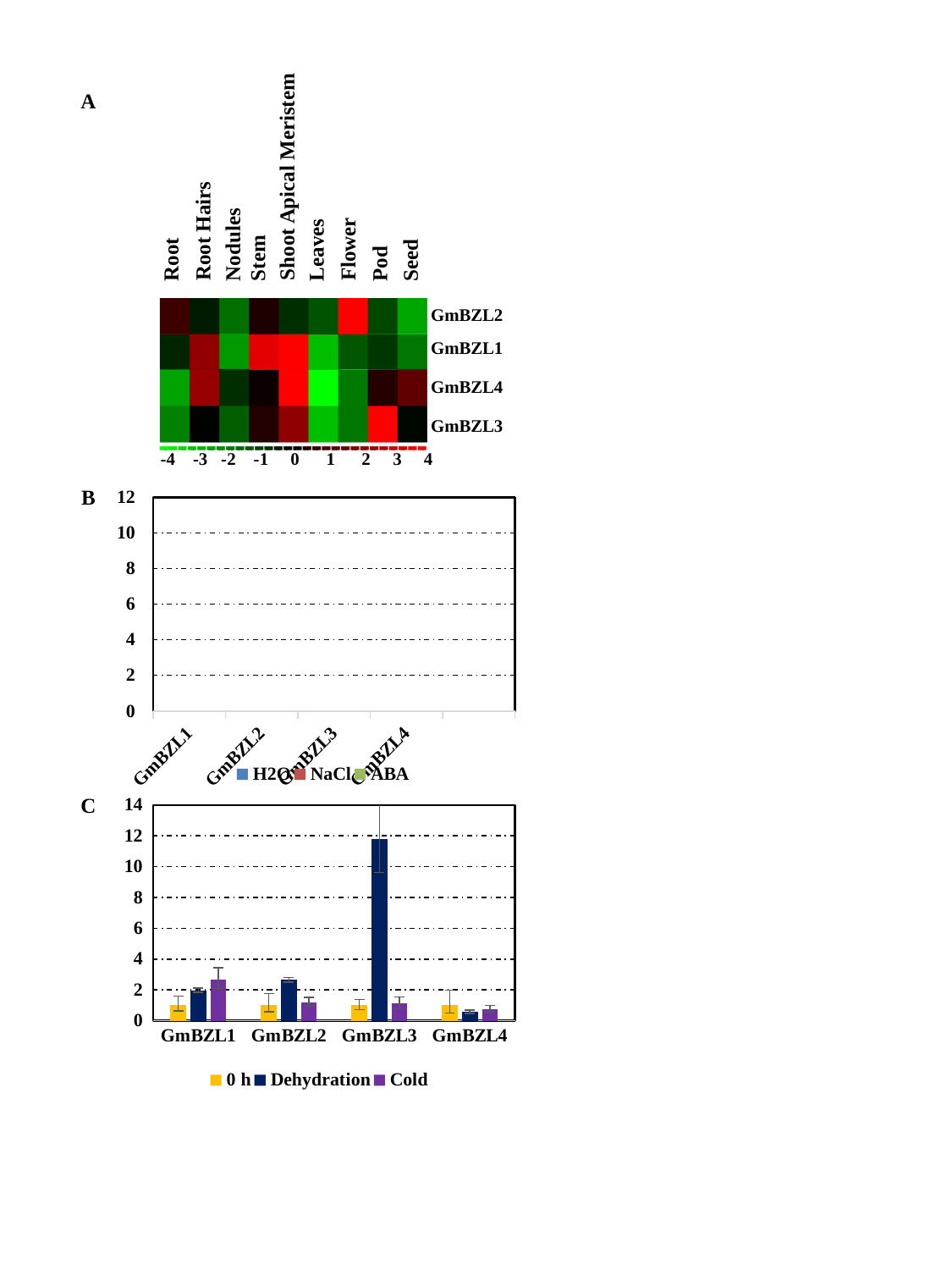
In chart C, is the Cold value for GmBZL1 greater or less than 2? greater In chart C, is the Dehydration value for GmBZL4 greater or less than 2? less In chart C, is the Dehydration value for GmBZL3 greater or less than 10? greater In chart C, how many series does the legend list? 3 In chart C, which is larger for GmBZL3: the Dehydration value or the Cold value? Dehydration In chart B, how many series does the legend list? 3 In chart A, how many tissue types are labelled across the top of the heatmap? 9 In chart C, what kind of chart is shown? bar chart In chart C, how many gene categories are shown on the x axis? 4 In chart C, which gene has the highest Dehydration value? GmBZL3 In chart C, which gene has the lowest Dehydration value? GmBZL4 In chart C, which gene has the highest Cold value? GmBZL1